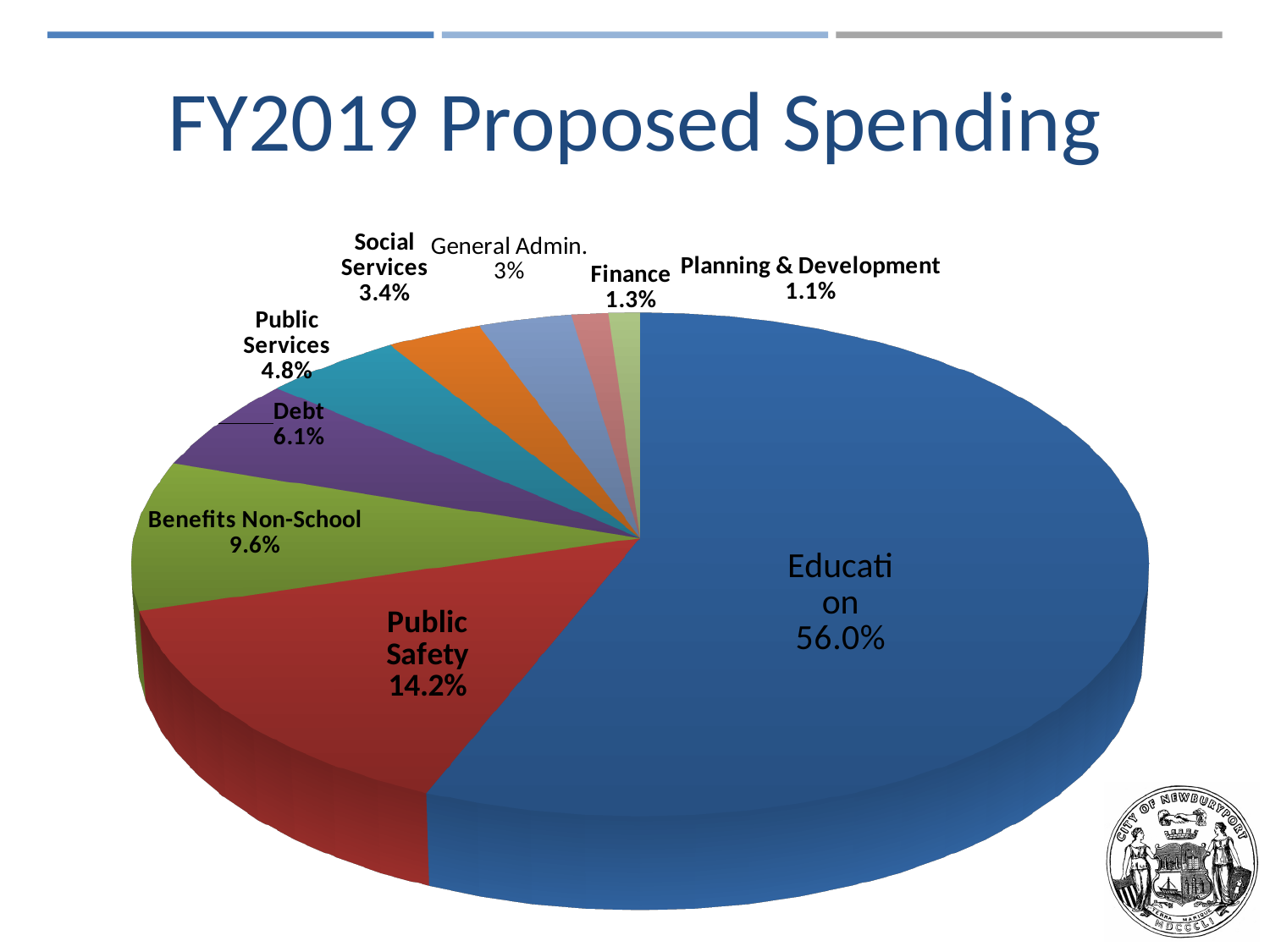
What share of FY2019 proposed spending goes to Education? 56.0% Which category has the smallest slice of the pie? Planning & Development What is the value shown for Benefits Non-School? 9.6% What percentage is labelled for Debt? 6.1% What share is shown for Planning & Development? 1.1% Which category has the largest slice of the pie? Education What is the title of the slide? FY2019 Proposed Spending What is the difference between the Public Safety share and the Benefits Non-School share? 4.6% Which is larger, Public Services or Social Services? Public Services What percentage of the pie is Public Safety? 14.2% How many categories are shown in the pie chart? 9 What kind of chart is shown on the slide? Pie chart